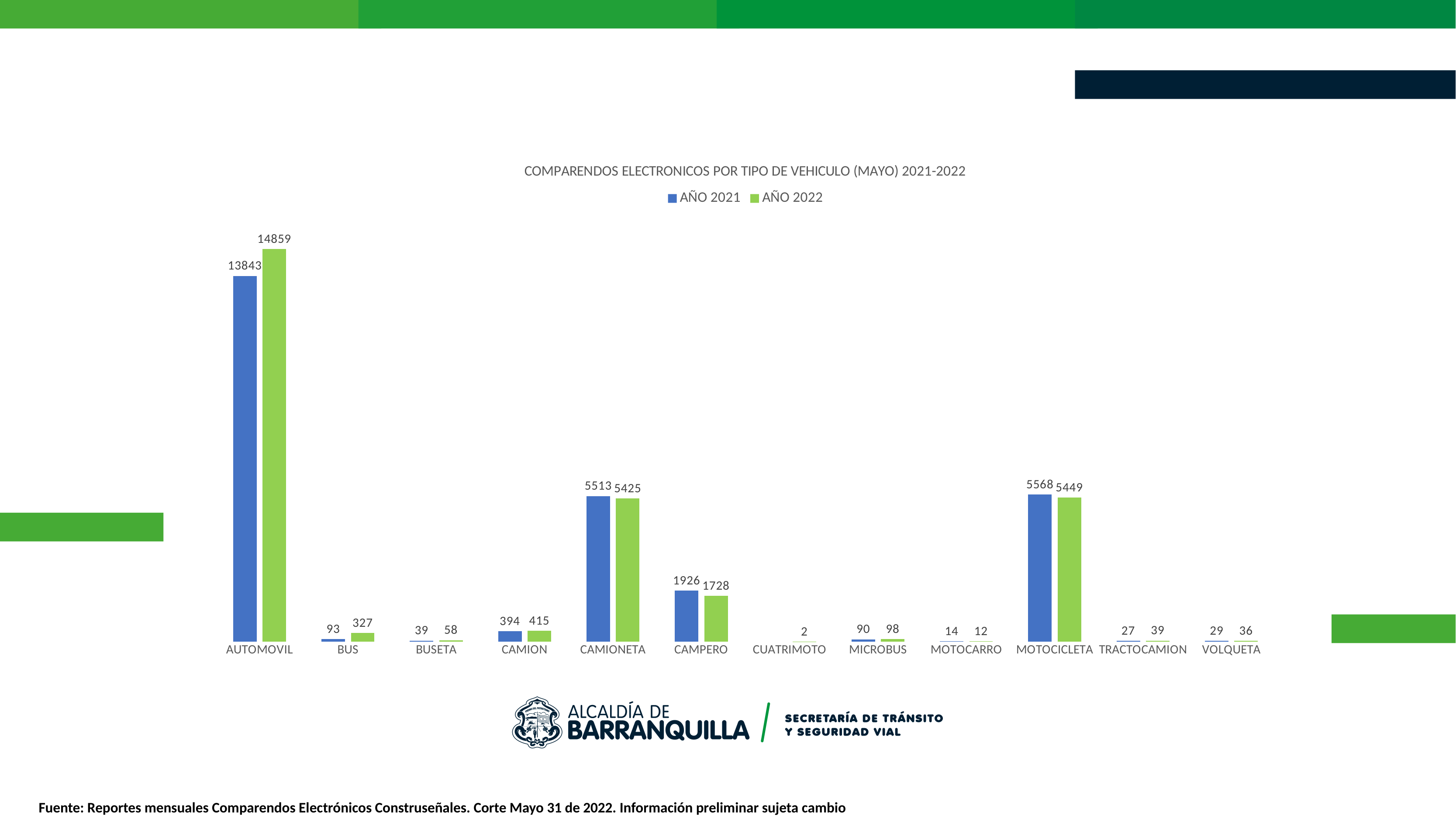
For CAMPERO, which is larger: the AÑO 2021 value or the AÑO 2022 value? AÑO 2021 What is the value for BUS in AÑO 2022? 327 What type of chart is shown on the slide? bar chart Which category has the highest value in AÑO 2021? AUTOMOVIL What is the title of the chart? COMPARENDOS ELECTRONICOS POR TIPO DE VEHICULO (MAYO) 2021-2022 What is the difference between the AÑO 2021 and AÑO 2022 values for CAMIONETA? 88 What is the value for MOTOCICLETA in AÑO 2021? 5568 How many vehicle-type categories are shown on the x axis? 12 What is the difference between the AÑO 2022 and AÑO 2021 values for AUTOMOVIL? 1016 What is the value for AUTOMOVIL in AÑO 2022? 14859 How many series does the legend list? 2 Which colour represents the AÑO 2022 series? green